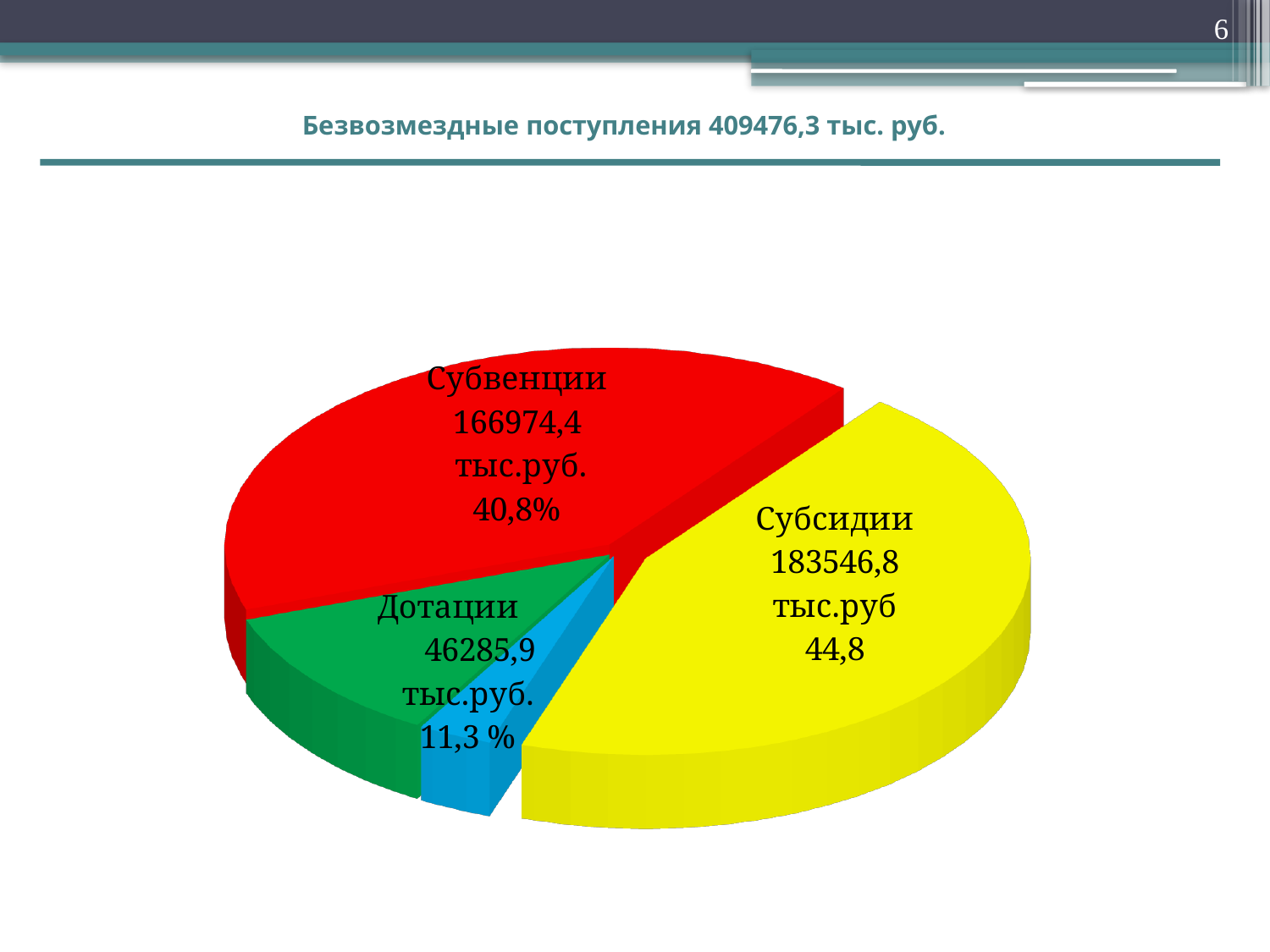
What is the value shown for Субвенции? 166974,4 тыс.руб. What share of the pie does Дотации represent? 11,3 % What colour is the Субсидии slice? yellow What share of the pie does Субвенции represent? 40,8% How many slices does the pie chart have? 4 What is the value shown for Субсидии? 183546,8 тыс.руб Which slice of the pie is the largest? Субсидии What is the value shown for Дотации? 46285,9 тыс.руб. Which is larger, Субвенции or Субсидии? Субсидии What is the difference between the values for Субсидии and Субвенции? 16572,4 тыс.руб. What kind of chart is shown on the slide? pie chart What share of the pie does Субсидии represent? 44,8